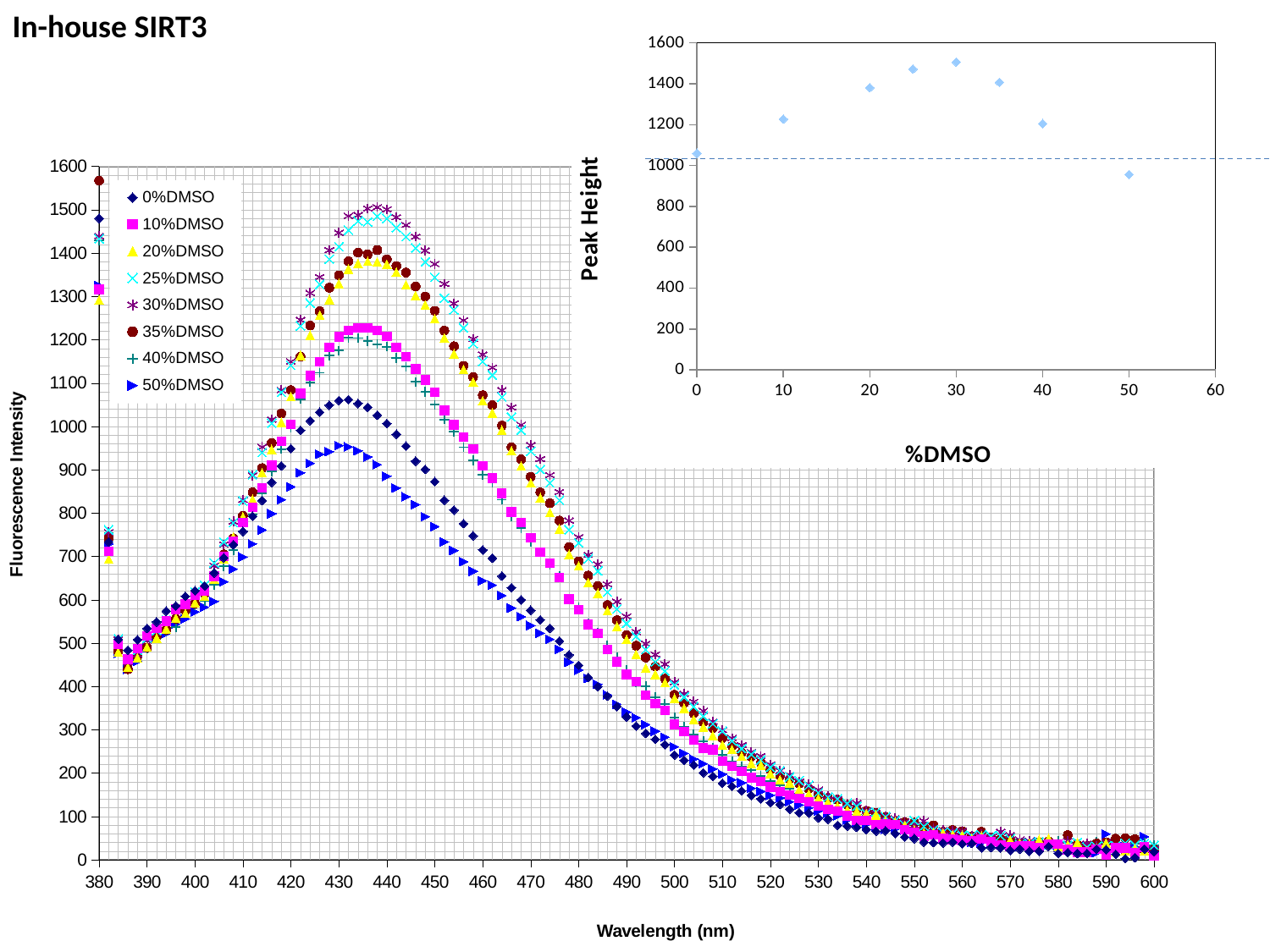
In the Fluorescence Intensity vs Wavelength chart (left), which series has a higher peak: 35%DMSO or 10%DMSO? 35%DMSO In the Peak Height vs %DMSO chart (top right), is the peak height at 30% DMSO greater or less than 1400? greater In the Peak Height vs %DMSO chart (top right), is the peak height at 50% DMSO greater or less than 1000? less In the Fluorescence Intensity vs Wavelength chart (left), is the peak fluorescence intensity of the 0%DMSO series greater or less than 1000? greater In the Peak Height vs %DMSO chart (top right), how many data points are plotted? 8 In the Fluorescence Intensity vs Wavelength chart (left), which series reaches the highest peak fluorescence intensity? 30%DMSO In the Fluorescence Intensity vs Wavelength chart (left), how many series does the legend list? 8 What is the x-axis title of the Fluorescence Intensity chart on the left? Wavelength (nm) In the Peak Height vs %DMSO chart (top right), at which %DMSO value is the peak height highest? 30 In the Fluorescence Intensity vs Wavelength chart (left), which series has the lowest peak fluorescence intensity? 50%DMSO In the Peak Height vs %DMSO chart (top right), does the peak height rise or fall as %DMSO increases from 30 to 50? fall In the Peak Height vs %DMSO chart (top right), at which %DMSO value is the peak height lowest? 50